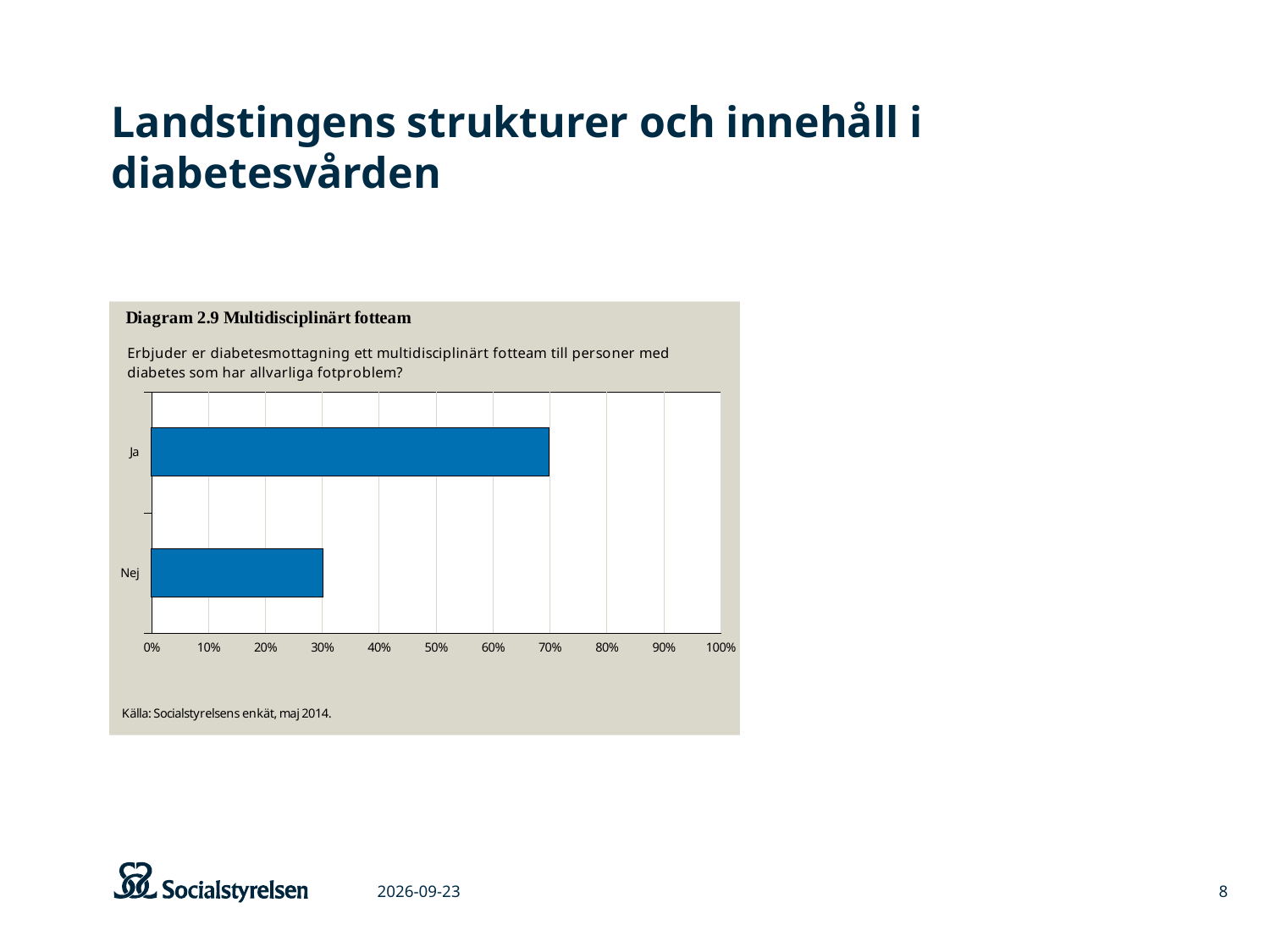
Is the value for Ja greater or less than 50%? greater Which category has the lowest value in the chart? Nej What kind of chart is shown in Diagram 2.9 Multidisciplinärt fotteam? bar chart What is the title of the diagram on the slide? Diagram 2.9 Multidisciplinärt fotteam Which category has the highest value in the chart? Ja What is the maximum value shown on the x axis of the chart? 100% Is the value for Nej greater or less than 40%? less Which is larger, the value for Ja or the value for Nej? Ja How many categories are plotted in the chart? 2